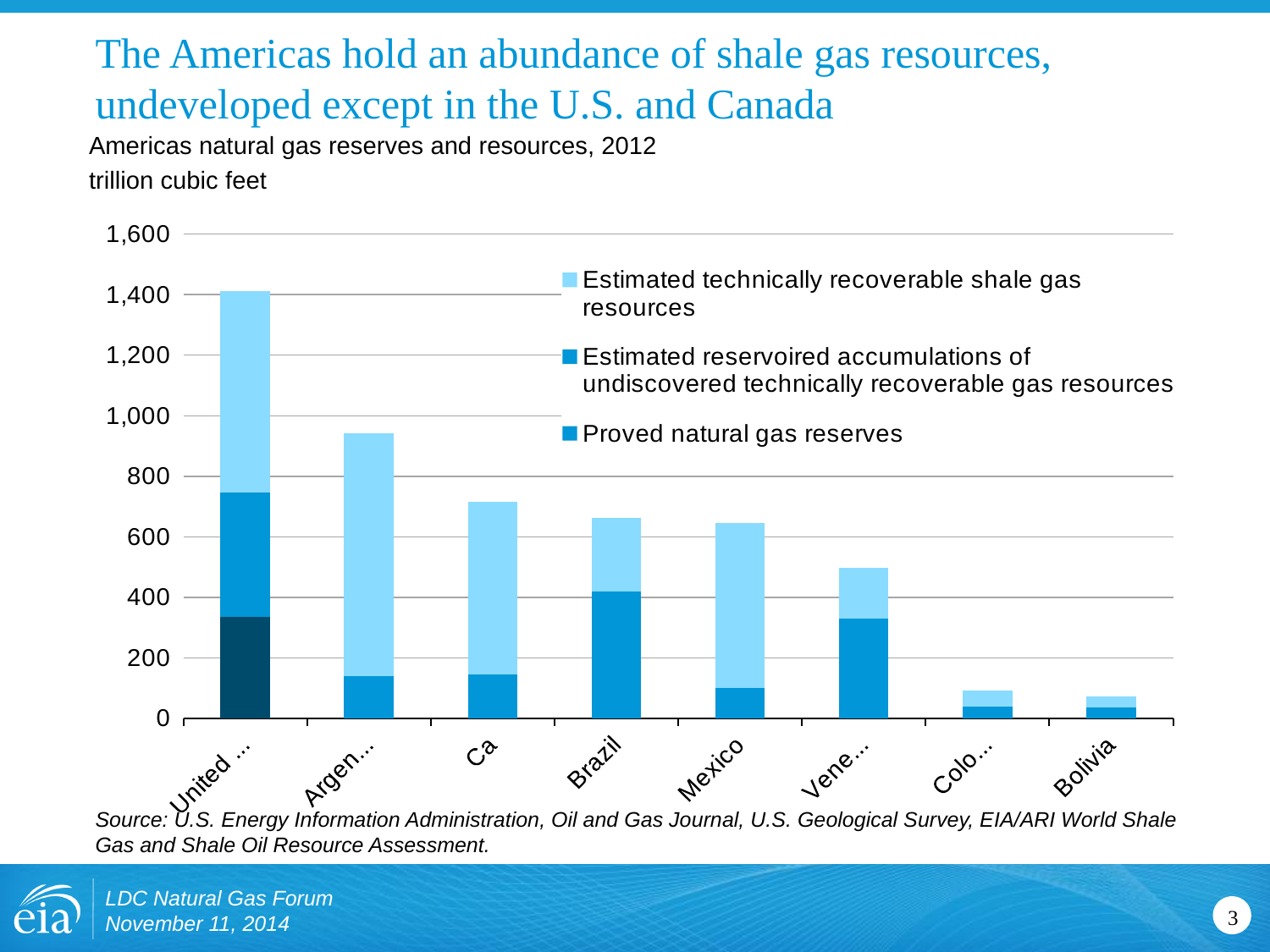
Which bar has the highest total on the chart? The leftmost bar (United ...) Do the bar totals generally rise or fall from left to right along the x axis? fall Is the total for Mexico greater or less than 800? less Which has a larger total, Brazil or Bolivia? Brazil Is the total for the leftmost bar greater or less than 1,200? greater How many countries (bars) are plotted on the chart? 8 What unit is the chart measured in? trillion cubic feet Is the total for Bolivia greater or less than 200? less What kind of chart is shown on the slide? Stacked bar chart How many series does the legend list? 3 Which country has the lowest total on the chart? Bolivia